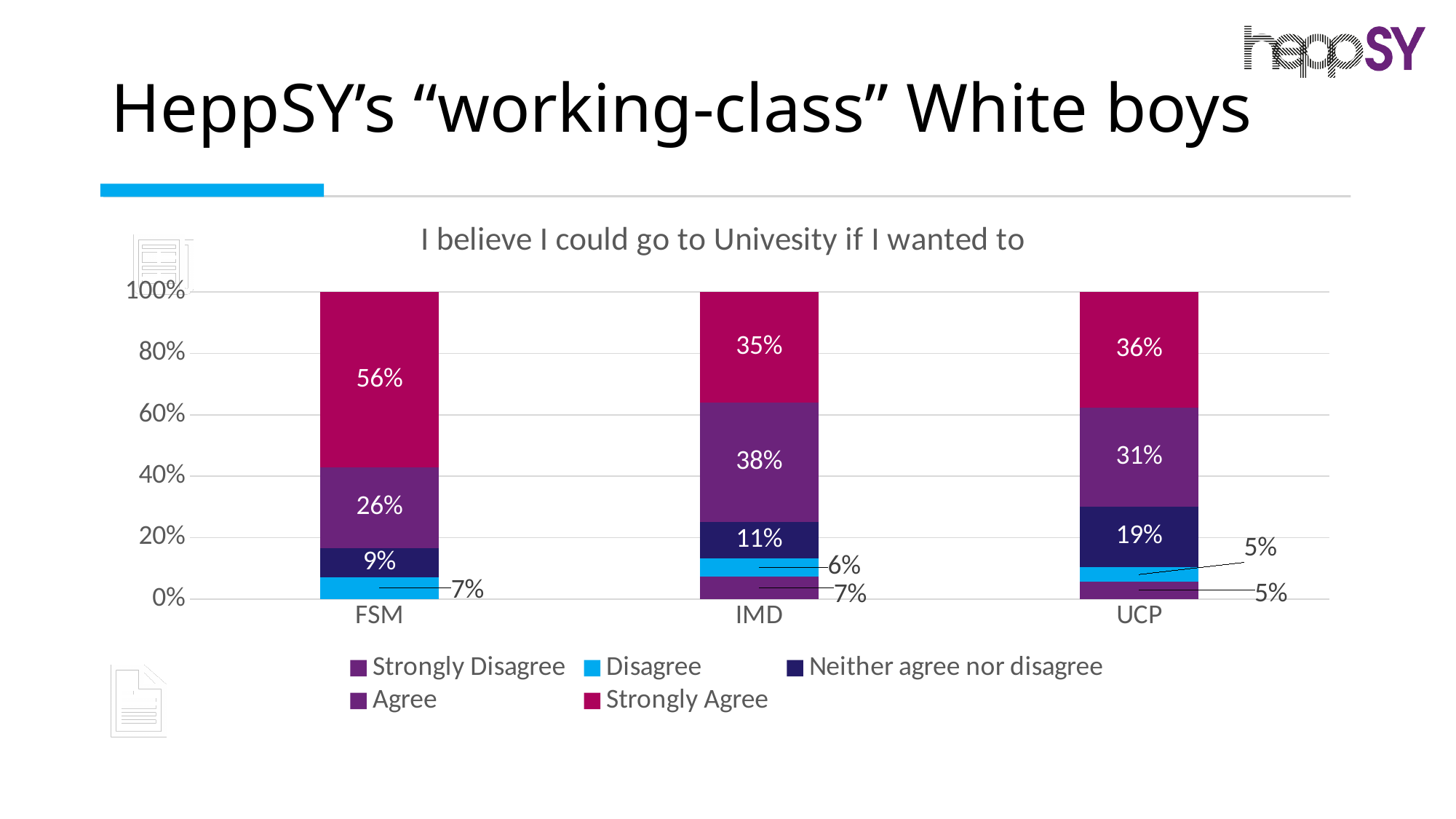
What is the Neither agree nor disagree value for UCP? 19% How many categories are shown on the x axis? 3 Which category has the lowest Neither agree nor disagree value? FSM What kind of chart is shown on the slide? Stacked bar chart What is the Agree value for IMD? 38% Which category has the highest Strongly Agree value? FSM What is the title of the chart? I believe I could go to Univesity if I wanted to How many series does the legend list? 5 What is the difference between the Strongly Agree values for FSM and IMD? 21% Which is larger, the Agree value for UCP or the Agree value for IMD? IMD What is the Strongly Agree value for FSM? 56% What is the Disagree value for IMD? 6%